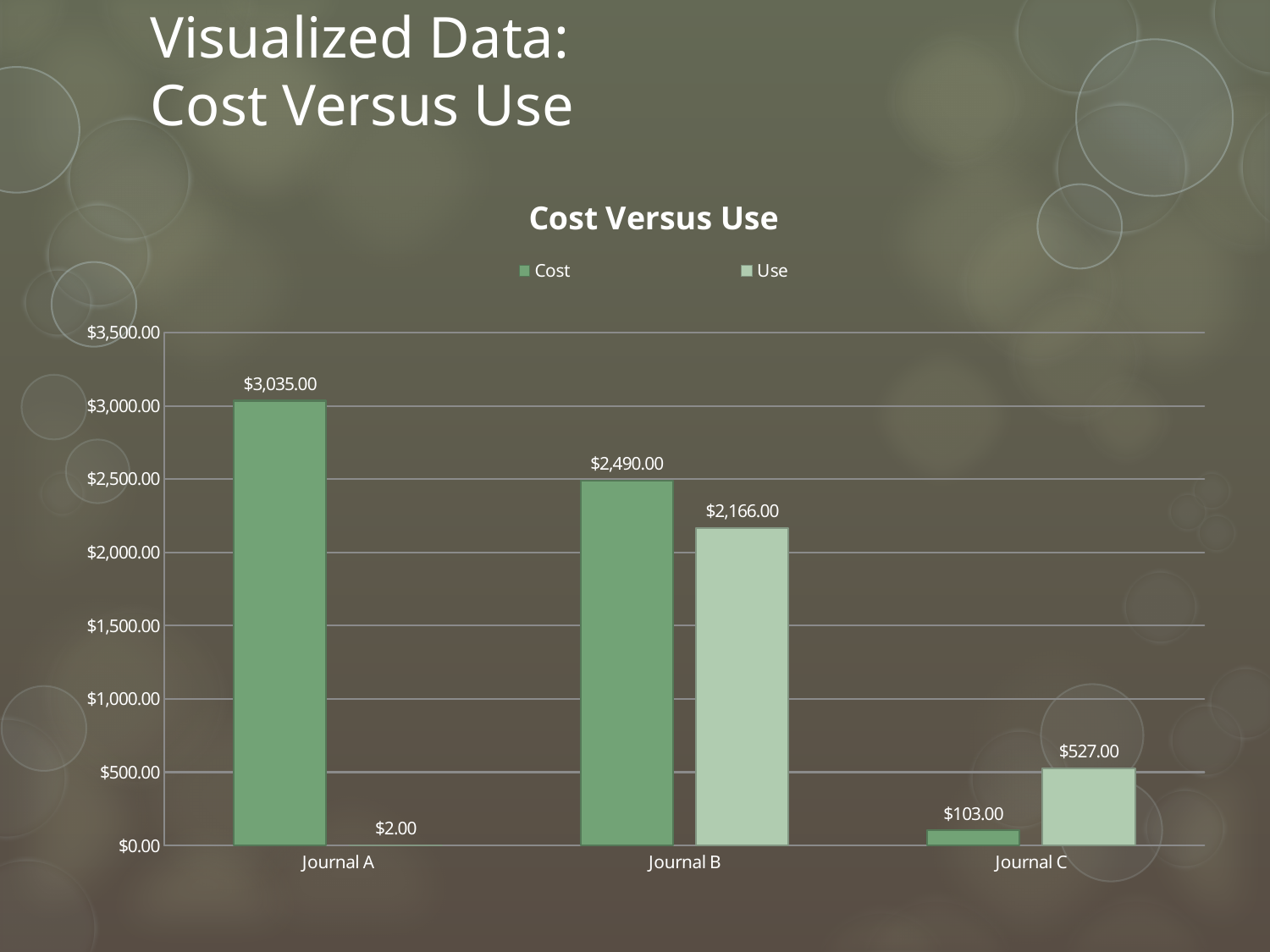
How many series does the legend list? 2 How many journals are shown on the x axis? 3 Which journal has the highest Cost? Journal A Which journal has the lowest Use value? Journal A What is the Use value for Journal A? $2.00 What kind of chart is shown on the slide? Bar chart What is the title of the chart? Cost Versus Use What is the Use value for Journal B? $2,166.00 What is the Cost value for Journal C? $103.00 For Journal C, which is larger, Cost or Use? Use What is the difference between the Cost and Use values for Journal B? $324.00 What is the Cost value for Journal A? $3,035.00